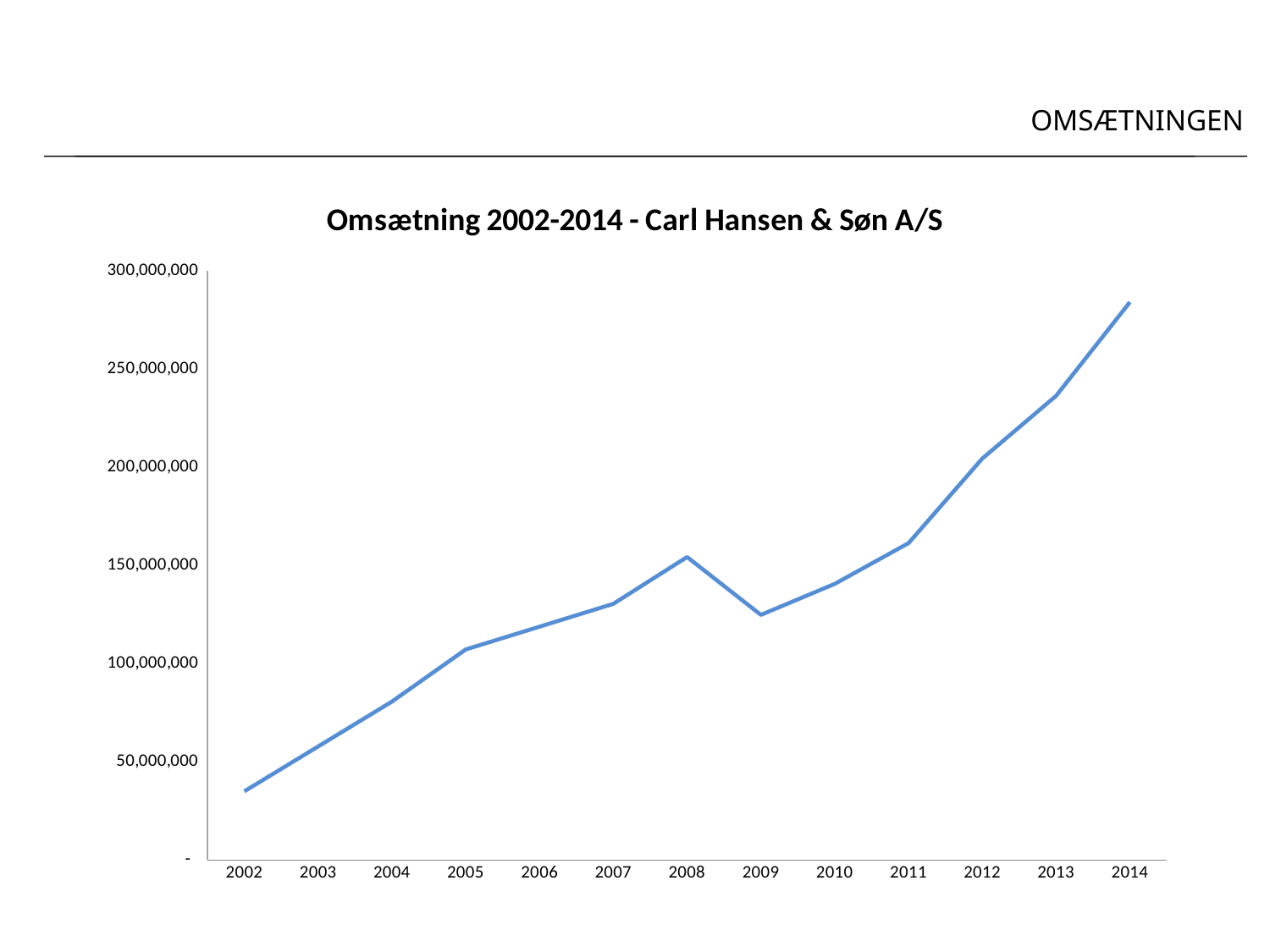
Is the value for 2009 greater or less than 150,000,000? less Which year has the highest value? 2014 What is the title of the chart? Omsætning 2002-2014 - Carl Hansen & Søn A/S How many years are plotted on the x axis? 13 Which year has the larger value, 2008 or 2009? 2008 Which year has the lowest value? 2002 Is the value for 2004 greater or less than 100,000,000? less What kind of chart is shown on the slide? line chart Is the value for 2002 greater or less than 50,000,000? less Do the values generally rise or fall from 2002 to 2014? rise